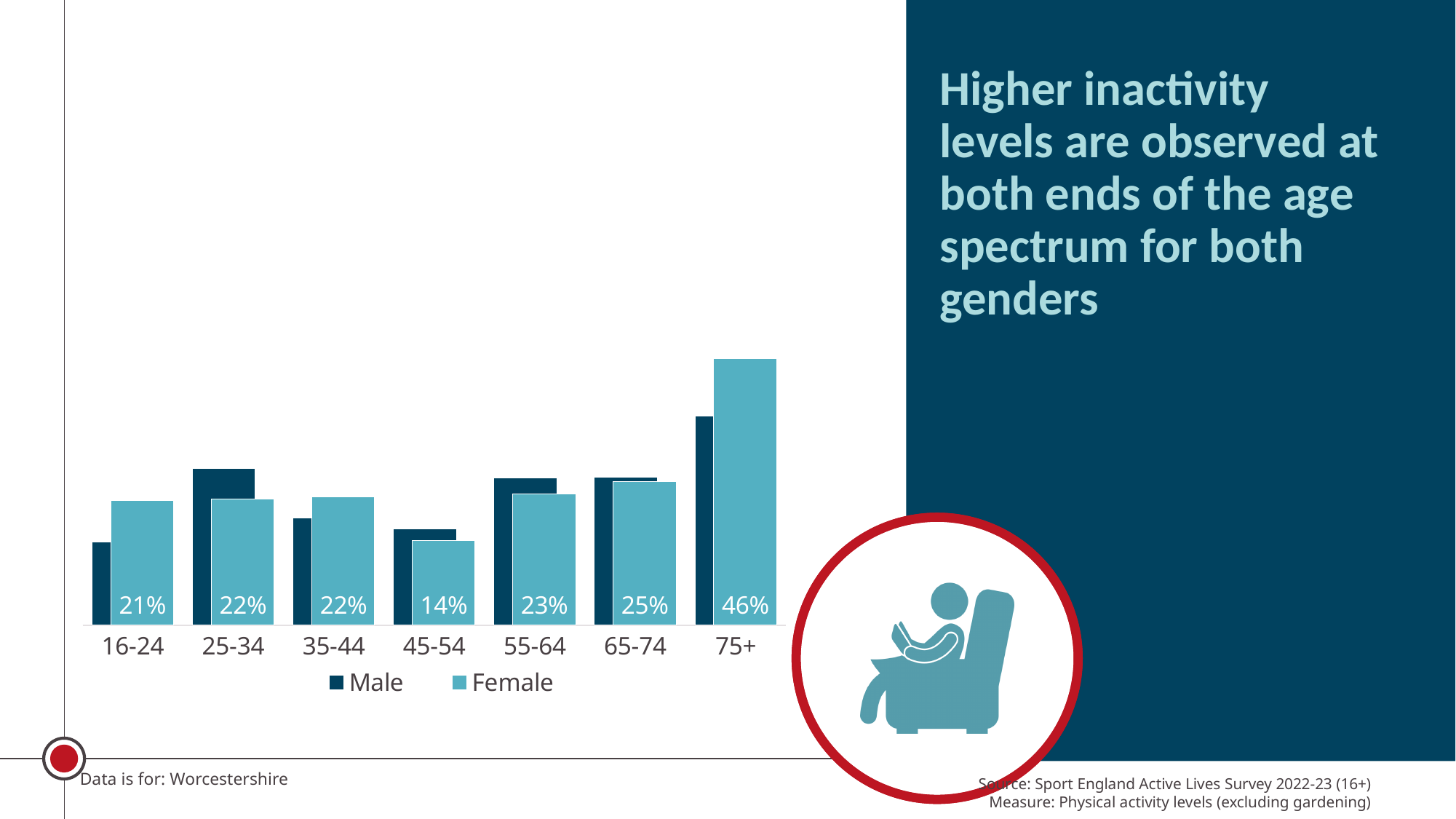
What kind of chart is shown on the slide? Bar chart Which age group has the highest Female value? 75+ What is the difference between the Female values for 75+ and 45-54? 32 percentage points In the 16-24 age group, which is larger, the Male bar or the Female bar? Female Which age group has the lowest Female value? 45-54 In the 25-34 age group, which is larger, the Male bar or the Female bar? Male What is the Female value for the 16-24 age group? 21% How many series does the legend list? 2 How many age groups are shown on the x axis? 7 What is the Female value for the 75+ age group? 46% What is the Female value for the 45-54 age group? 14% What is the Female value for the 65-74 age group? 25%